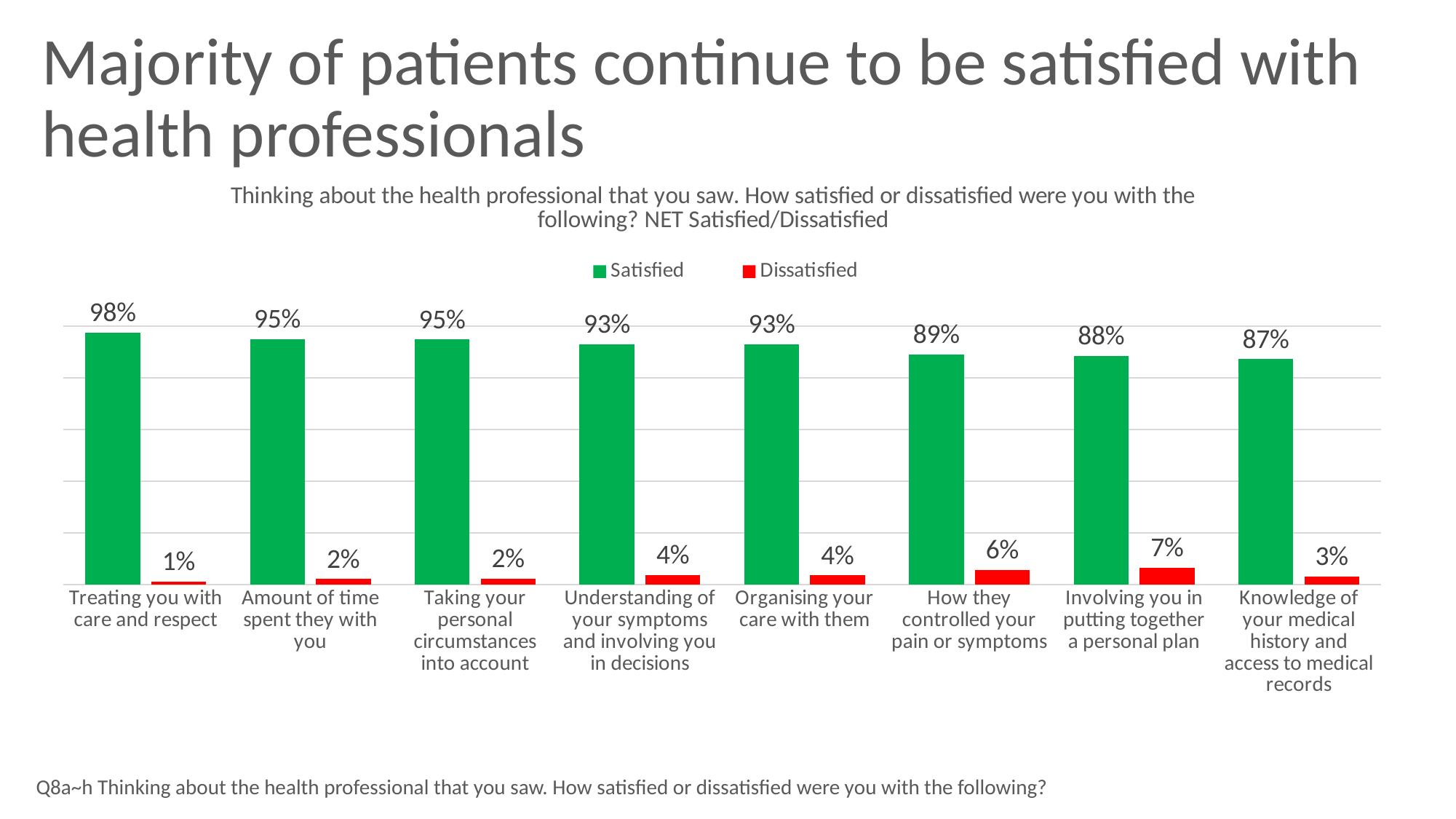
How many categories are shown on the x axis? 8 What is the Dissatisfied value for 'Involving you in putting together a personal plan'? 7% What is the Satisfied value for 'Treating you with care and respect'? 98% What colour represents the Dissatisfied series? Red Which category has the highest Satisfied value? Treating you with care and respect Which is larger: the Dissatisfied value for 'How they controlled your pain or symptoms' or for 'Organising your care with them'? How they controlled your pain or symptoms What is the Satisfied value for 'Knowledge of your medical history and access to medical records'? 87% What kind of chart is shown on the slide? Bar chart Which category has the highest Dissatisfied value? Involving you in putting together a personal plan How many series does the legend list? 2 What is the difference between the Satisfied values for 'Treating you with care and respect' and 'Knowledge of your medical history and access to medical records'? 11% Which category has the lowest Satisfied value? Knowledge of your medical history and access to medical records